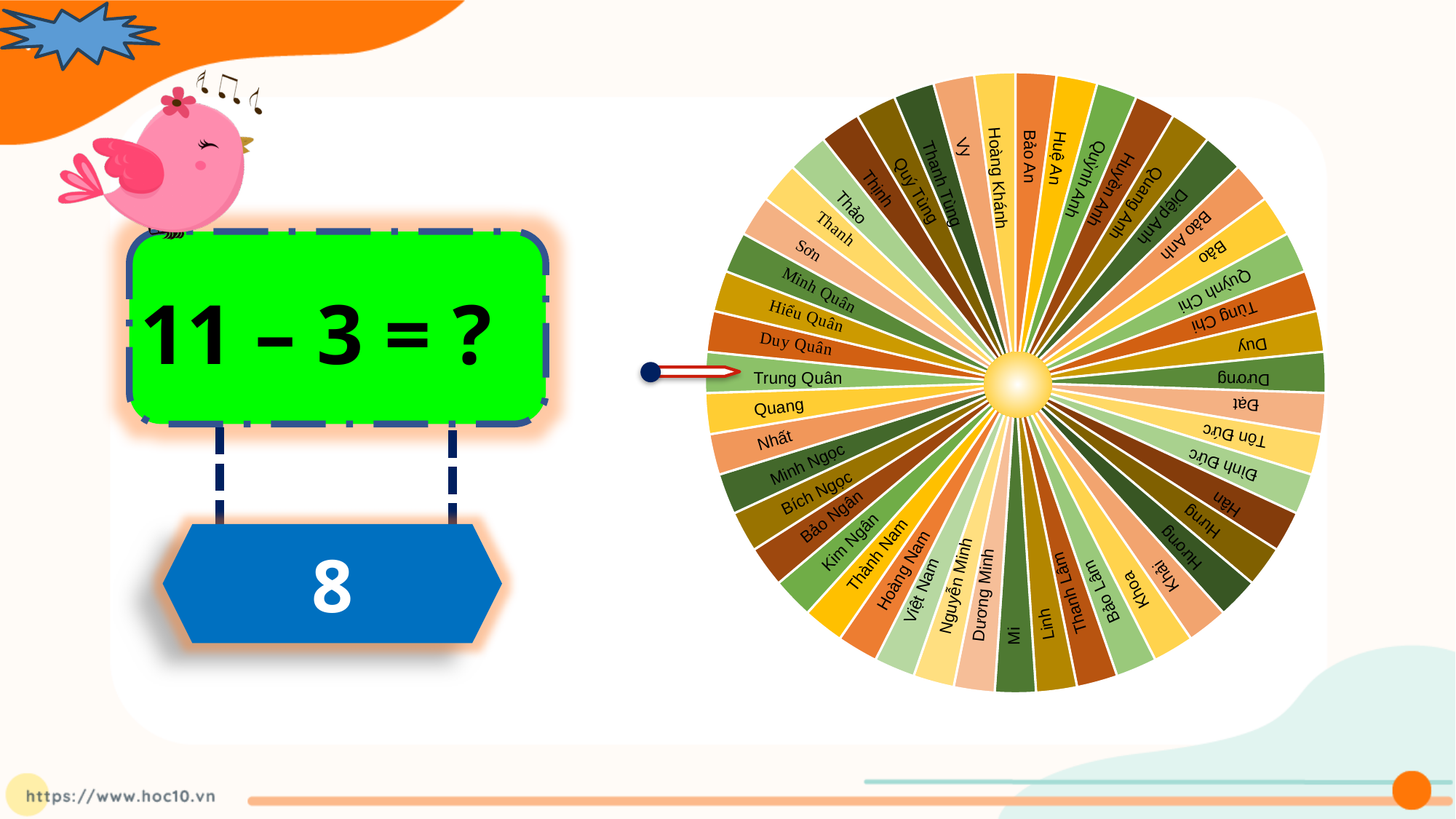
Which name on the wheel does the arrow pointer point to? Trung Quân Which name is on the slice directly above the slice labelled Trung Quân on the wheel? Duy Quân Which name is on the slice directly below the slice labelled Trung Quân on the wheel? Quang What kind of chart is the wheel on the right side of the slide? pie chart Which name is on the slice at the very top of the wheel, to the right of Hoàng Khánh? Bảo An Which name is on the slice at the bottom of the wheel between Dương Minh and Linh? Mi